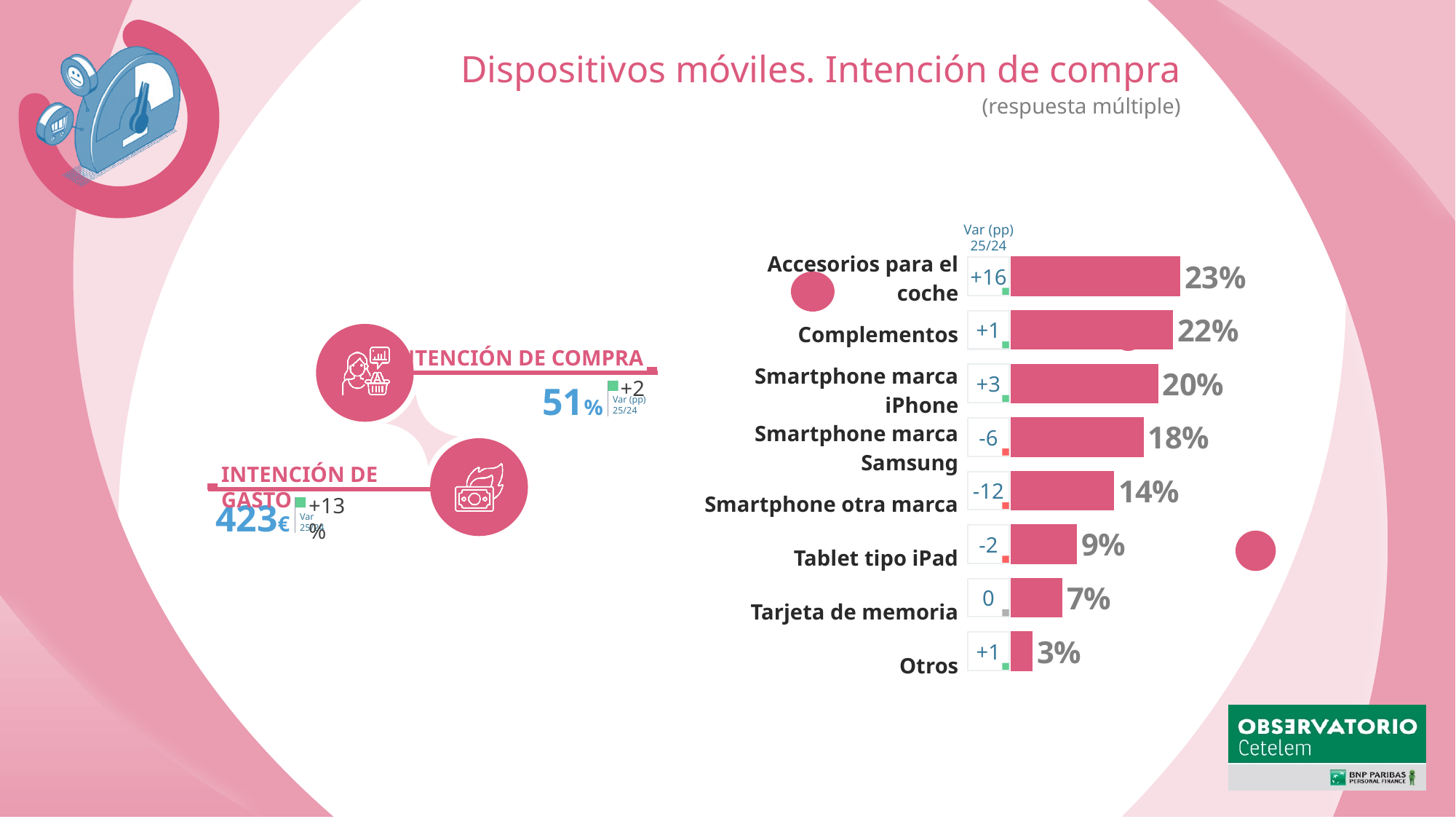
What is the title of the slide? Dispositivos móviles. Intención de compra Which is larger, Complementos or Tarjeta de memoria? Complementos What is the value for Smartphone marca Samsung? 18% Which category has the lowest value? Otros What is the Var (pp) 25/24 shown for Smartphone otra marca? -12 What is the Var (pp) 25/24 shown for Accesorios para el coche? +16 What is the difference between Smartphone marca iPhone and Smartphone otra marca? 6 percentage points What is the value for Tablet tipo iPad? 9% What kind of chart is shown on the slide? Bar chart Which category has the highest value? Accesorios para el coche How many categories are shown in the bar chart? 8 What is the value for Accesorios para el coche? 23%